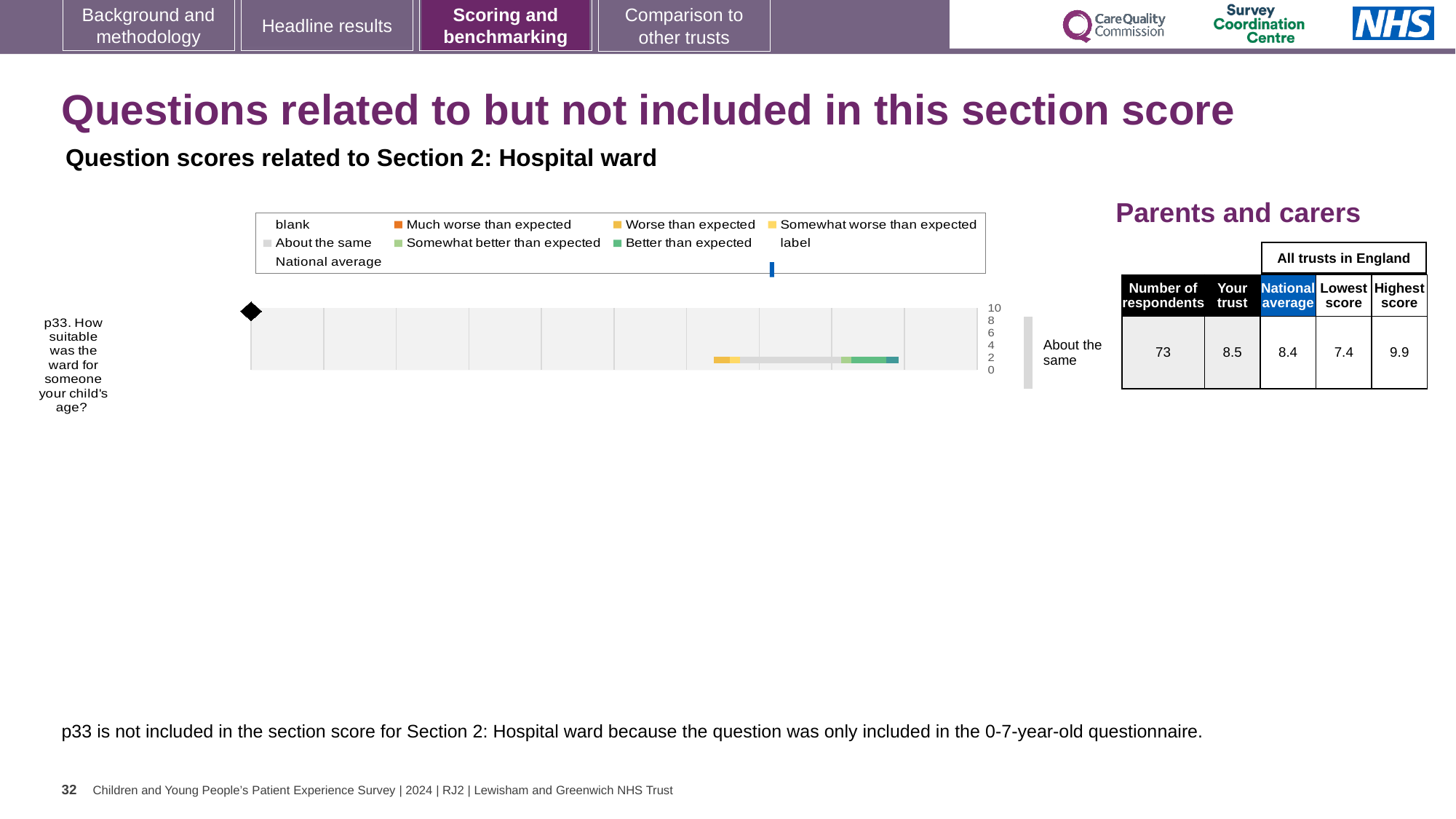
What is the highest value shown on the chart's score axis? 10 What is the difference between the highest score (9.9) and the lowest score (7.4) for p33? 2.5 How many respondents answered question p33? 73 What is the highest score among all trusts in England for p33? 9.9 Which benchmark category is shown for p33 (How suitable was the ward for someone your child's age?)? About the same Which respondent group does the chart and table on this slide relate to? Parents and carers What is the lowest score among all trusts in England for p33? 7.4 What is the national average score for p33? 8.4 For p33, which is higher: the 'Your trust' score or the national average? Your trust How many survey questions are plotted in the chart on this slide? 1 What is the 'Your trust' score for p33 in the table beside the chart? 8.5 What kind of chart is used to show the benchmarking result for question p33? Bar chart